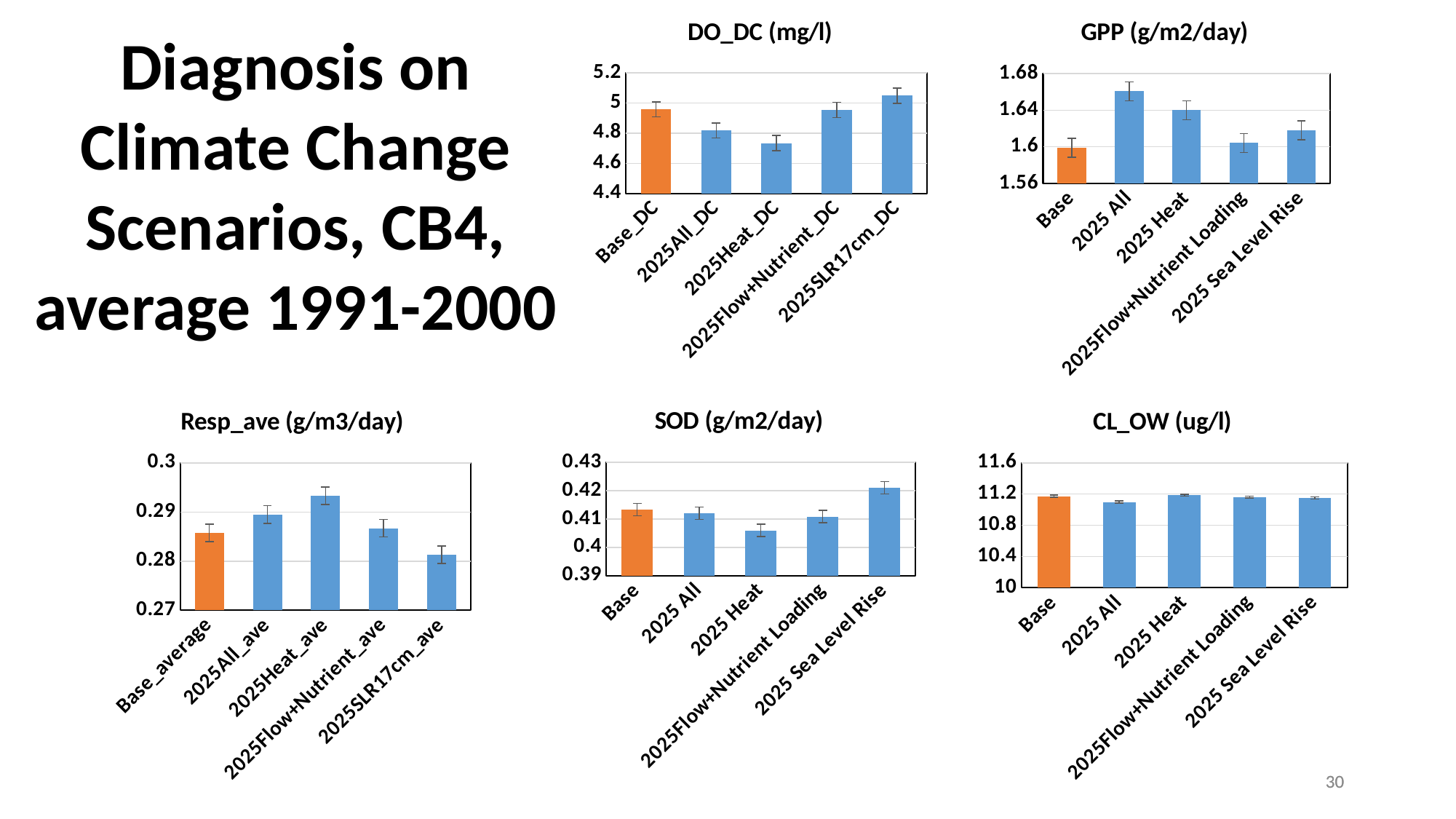
How many categories are shown in the SOD (g/m2/day) chart? 5 What kind of chart is the GPP (g/m2/day) chart? bar chart In the CL_OW (ug/l) chart, is the value for Base greater or less than 10.8? greater In the GPP (g/m2/day) chart, which category has the highest value? 2025 All In the DO_DC (mg/l) chart, which category has the lowest value? 2025Heat_DC In the SOD (g/m2/day) chart, is the value for 2025 Heat greater or less than 0.41? less In the DO_DC (mg/l) chart, is the value for 2025Heat_DC greater or less than 4.8? less In the SOD (g/m2/day) chart, which category has the highest value? 2025 Sea Level Rise In the Resp_ave (g/m3/day) chart, which category has the highest value? 2025Heat_ave In the Resp_ave (g/m3/day) chart, which category has the lowest value? 2025SLR17cm_ave